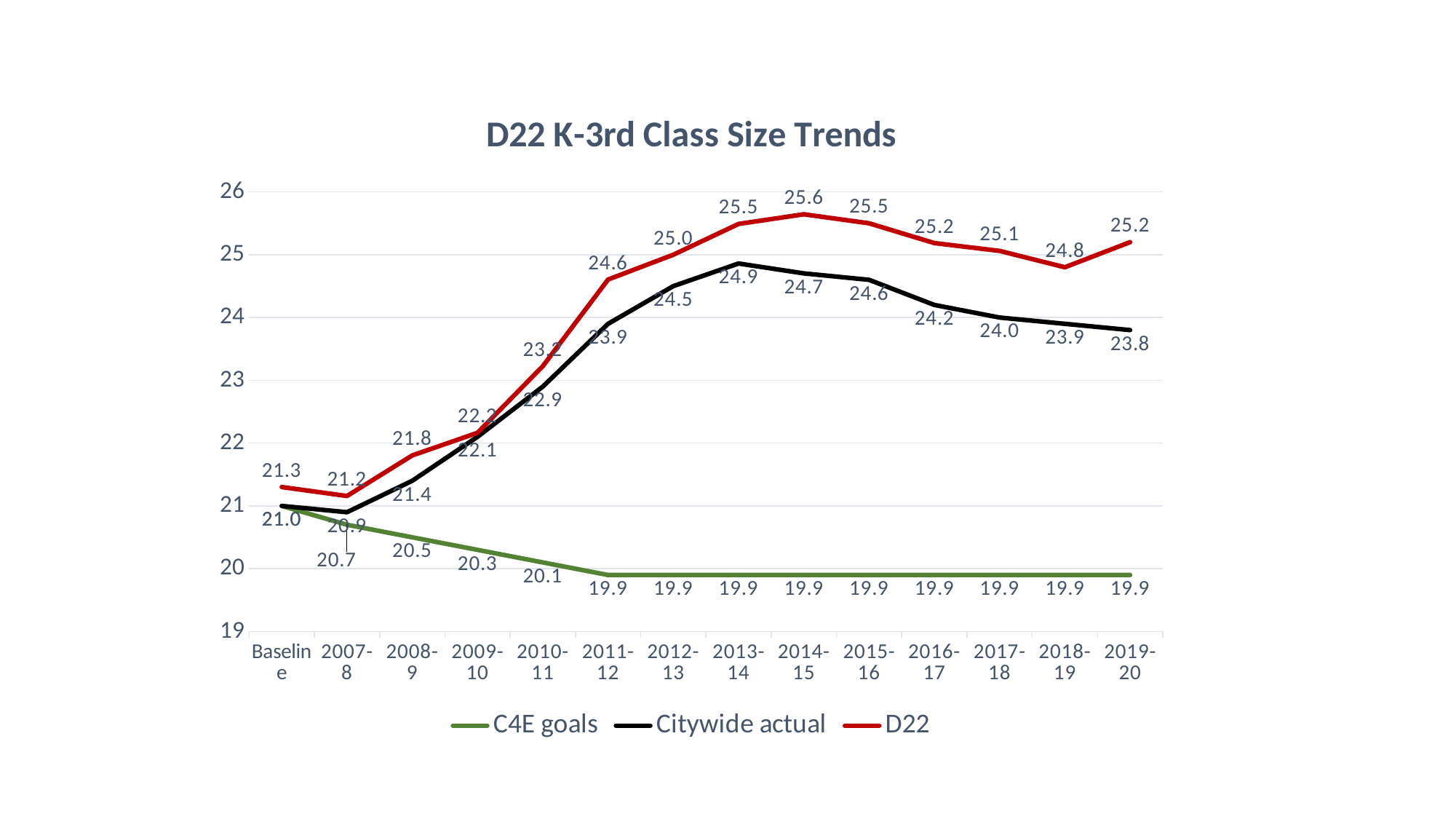
What kind of chart is shown on the slide? Line chart In which year does the D22 series reach its highest value? 2014-15 What is the difference between the D22 value and the Citywide actual value in 2013-14? 0.6 Which is larger in 2018-19, the D22 value or the Citywide actual value? D22 What is the title of the chart? D22 K-3rd Class Size Trends In which year is the Citywide actual series at its lowest value? 2007-8 What is the Citywide actual value for 2019-20? 23.8 How many categories are shown on the x axis? 14 What is the C4E goals value for 2009-10? 20.3 What is the D22 value for 2014-15? 25.6 Does the C4E goals series rise or fall from Baseline to 2011-12? Fall How many series does the legend list? 3